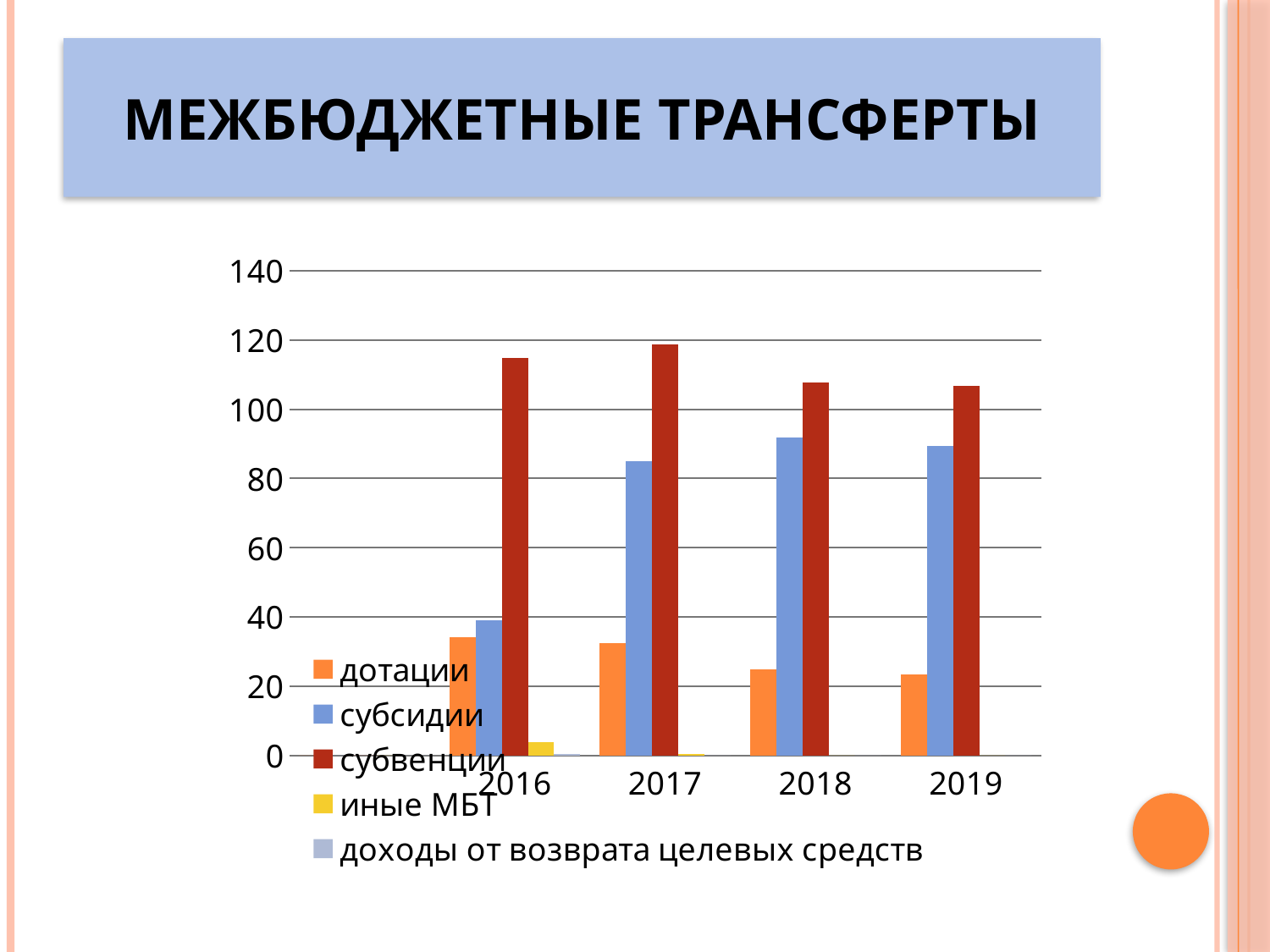
In which year is the value for субсидии lowest? 2016 Is the value for субсидии in 2016 greater or less than 60? less How many series does the legend list? 5 What is the title of the slide with the chart? МЕЖБЮДЖЕТНЫЕ ТРАНСФЕРТЫ Is the value for дотации in 2018 greater or less than 40? less How many years are shown on the x axis? 4 Which series is highest in 2018? субвенции What colour are the bars for субвенции? dark red What kind of chart is shown on the slide? bar chart In 2019, which is larger: дотации or субсидии? субсидии Do the values for дотации rise or fall from 2016 to 2019? fall Is the value for субвенции in 2017 greater or less than 100? greater